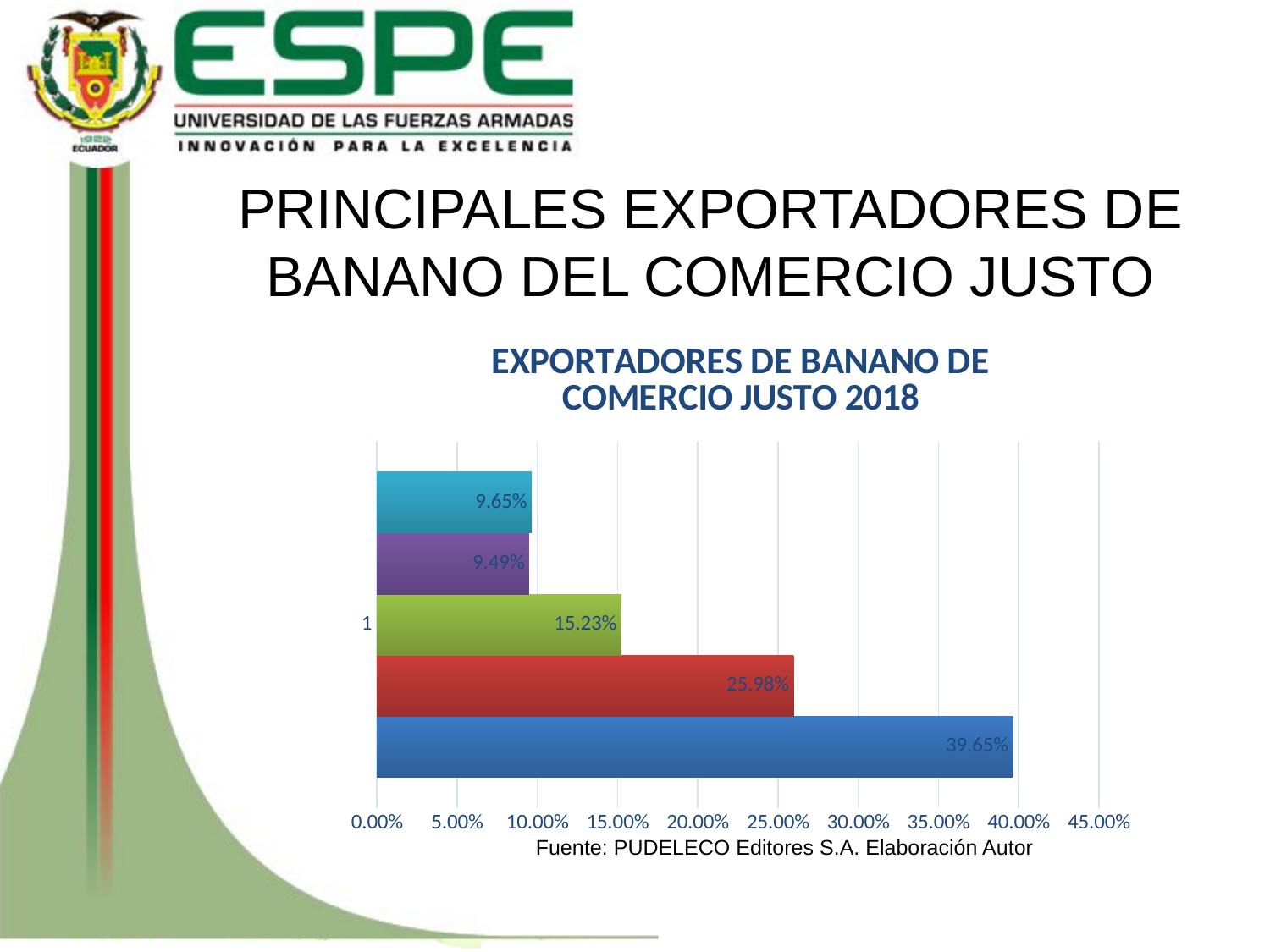
How many bars are plotted in the chart? 5 Which is larger, the red bar or the green bar? The red bar What is the title of the chart? EXPORTADORES DE BANANO DE COMERCIO JUSTO 2018 What is the value shown on the blue bar (the longest bar at the bottom)? 39.65% What is the value shown on the red bar? 25.98% Which bar has the highest value in the chart? The blue bar (39.65%) What is the value shown on the purple bar? 9.49% What is the value shown on the topmost (light blue) bar? 9.65% What is the difference between the blue bar (39.65%) and the red bar (25.98%)? 13.67% Is the value of the green bar greater or less than 20.00%? less What type of chart is shown on the slide? Bar chart What is the value shown on the green bar? 15.23%